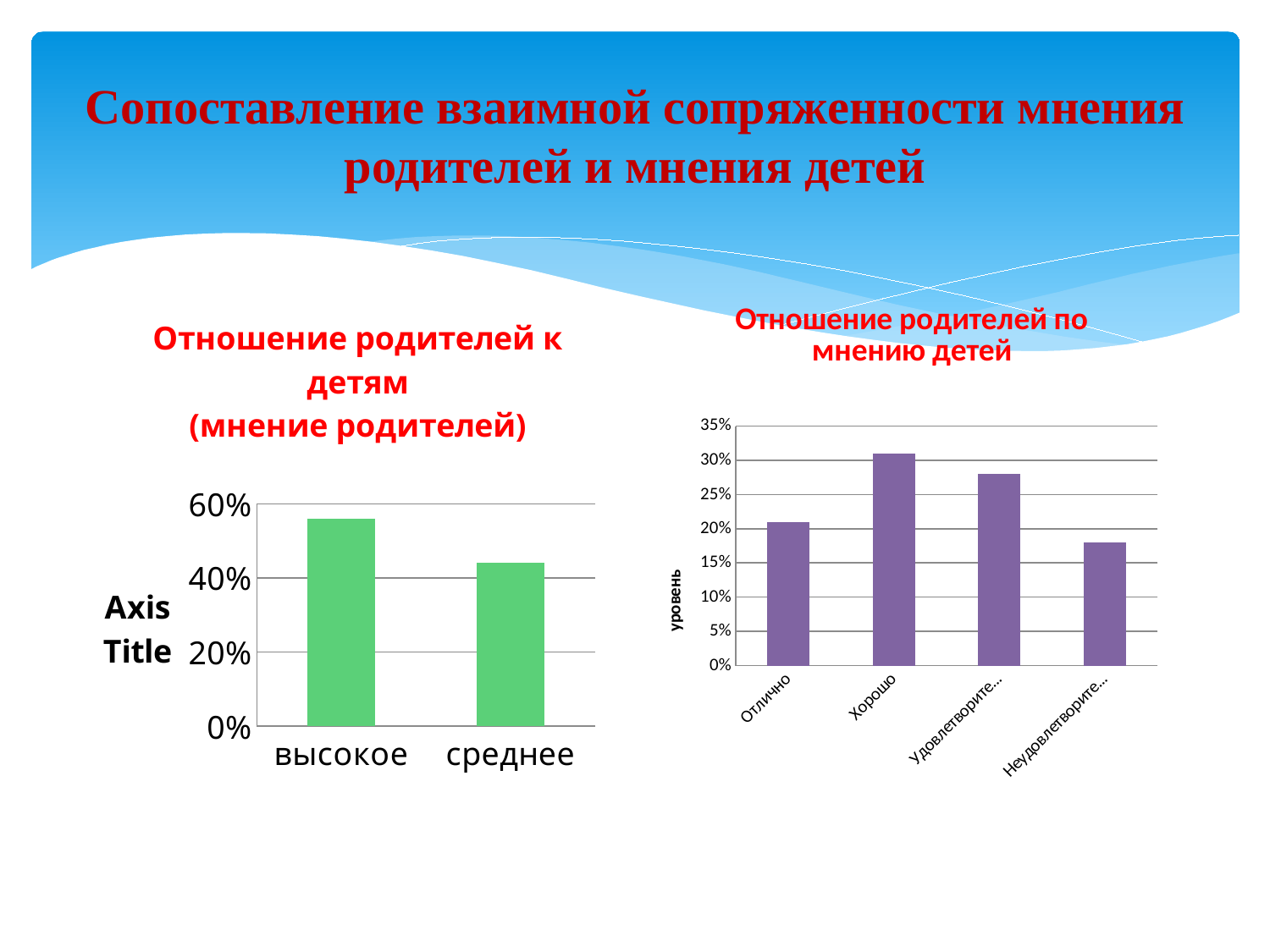
What type of chart is the left chart titled "Отношение родителей к детям (мнение родителей)"? bar chart In the right chart "Отношение родителей по мнению детей", which is larger: the value for "Отлично" or the value for "Хорошо"? Хорошо In the right chart "Отношение родителей по мнению детей", is the value for "Отлично" greater or less than 25%? less How many bars are shown in the right chart "Отношение родителей по мнению детей"? 4 What type of chart is the right chart titled "Отношение родителей по мнению детей"? bar chart In the right chart "Отношение родителей по мнению детей", which category has the lowest value? Неудовлетворите... In the left chart "Отношение родителей к детям (мнение родителей)", is the value for "среднее" greater or less than 60%? less How many categories are shown in the left chart "Отношение родителей к детям (мнение родителей)"? 2 In the left chart "Отношение родителей к детям (мнение родителей)", which category has the highest value? высокое What is the vertical axis title of the right chart "Отношение родителей по мнению детей"? уровень In the right chart "Отношение родителей по мнению детей", which category has the highest value? Хорошо In the left chart "Отношение родителей к детям (мнение родителей)", is the value for "высокое" greater or less than 40%? greater